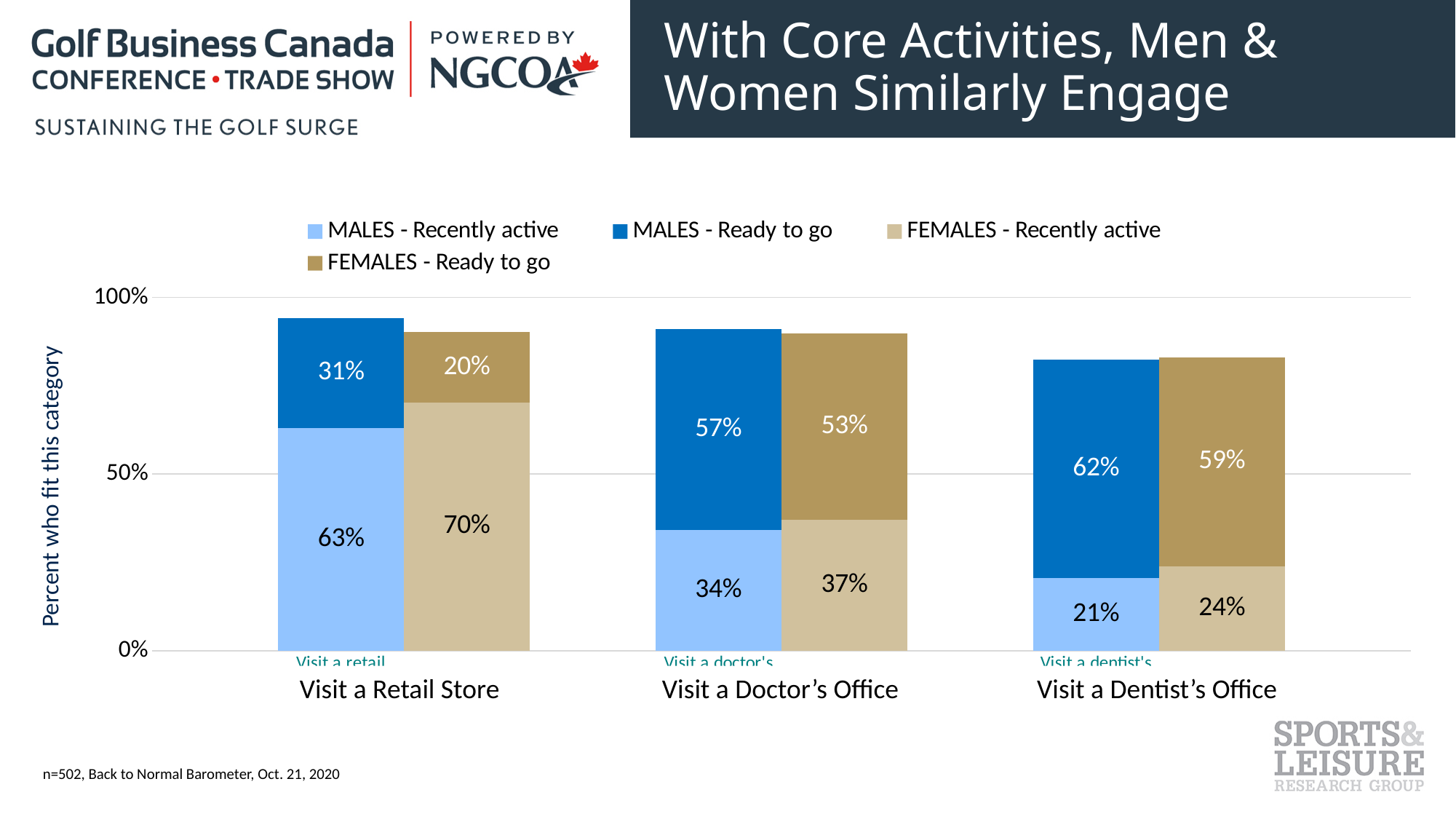
Which is larger for Visit a Doctor's Office: 'MALES - Ready to go' or 'FEMALES - Ready to go'? MALES - Ready to go How many activity categories are shown on the x axis? 3 What is the total of the female stacked bar for Visit a Dentist's Office? 83% What percentage of males are 'Recently active' for Visit a Retail Store? 63% What percentage of females are 'Ready to go' for Visit a Doctor's Office? 53% What is the difference between the 'FEMALES - Recently active' and 'MALES - Recently active' values for Visit a Retail Store? 7% What is the total of the male stacked bar for Visit a Retail Store? 94% How many series does the legend list? 4 What percentage of females are 'Recently active' for Visit a Dentist's Office? 24% What type of chart is shown on the slide? Stacked bar chart Which activity has the highest 'MALES - Ready to go' value? Visit a Dentist's Office Which activity has the lowest 'FEMALES - Recently active' value? Visit a Dentist's Office